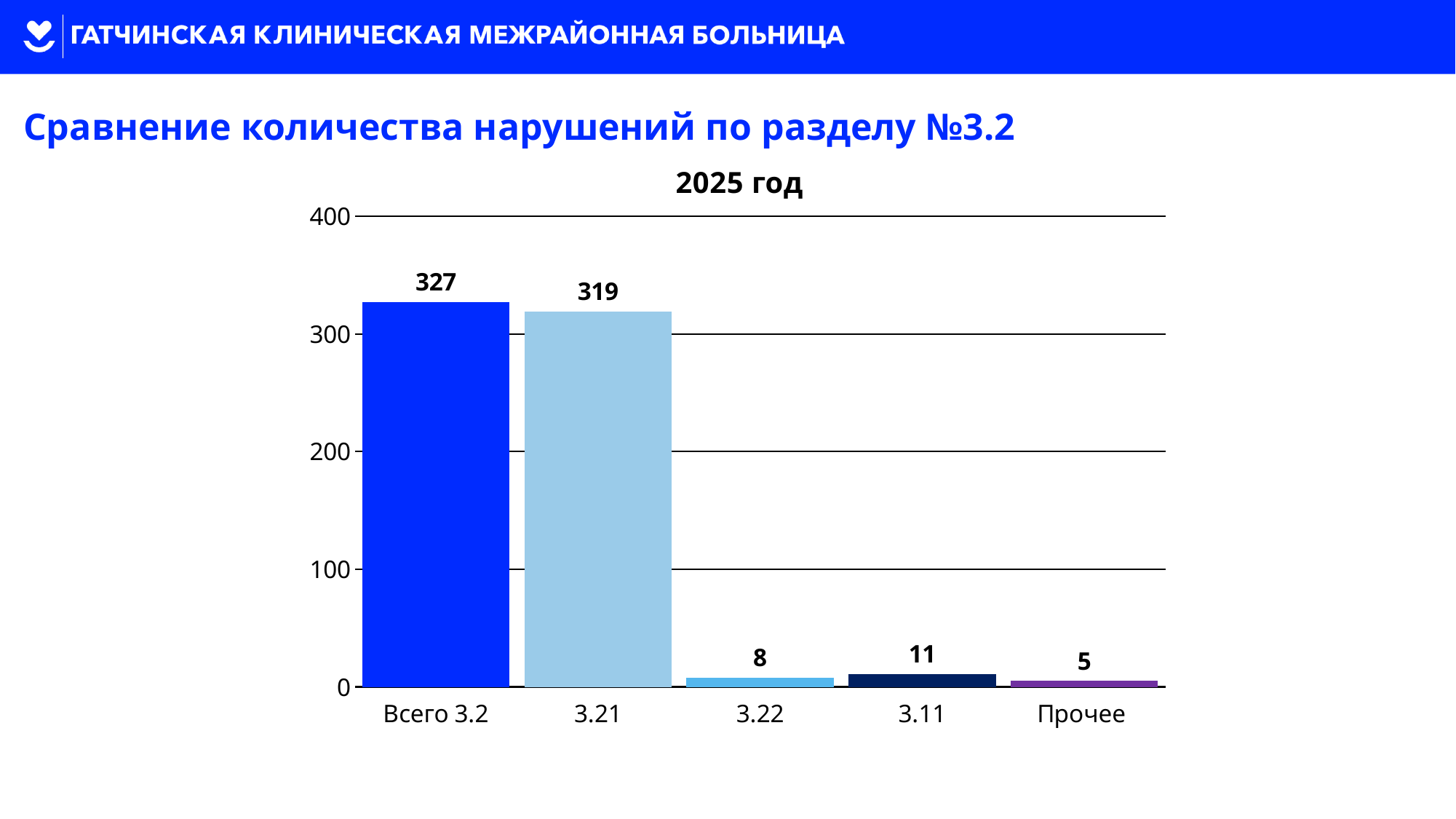
What is the value for 3.21? 319 What kind of chart is shown on the slide? Bar chart What is the value for Прочее? 5 What is the value for 3.11? 11 What is the difference between the values for Всего 3.2 and 3.21? 8 Which category has the highest value? Всего 3.2 How many categories are shown on the x axis? 5 What is the title of the chart? 2025 год Which is larger, the value for 3.22 or the value for 3.11? 3.11 Which category has the lowest value? Прочее What is the value for 3.22? 8 What is the value for Всего 3.2? 327